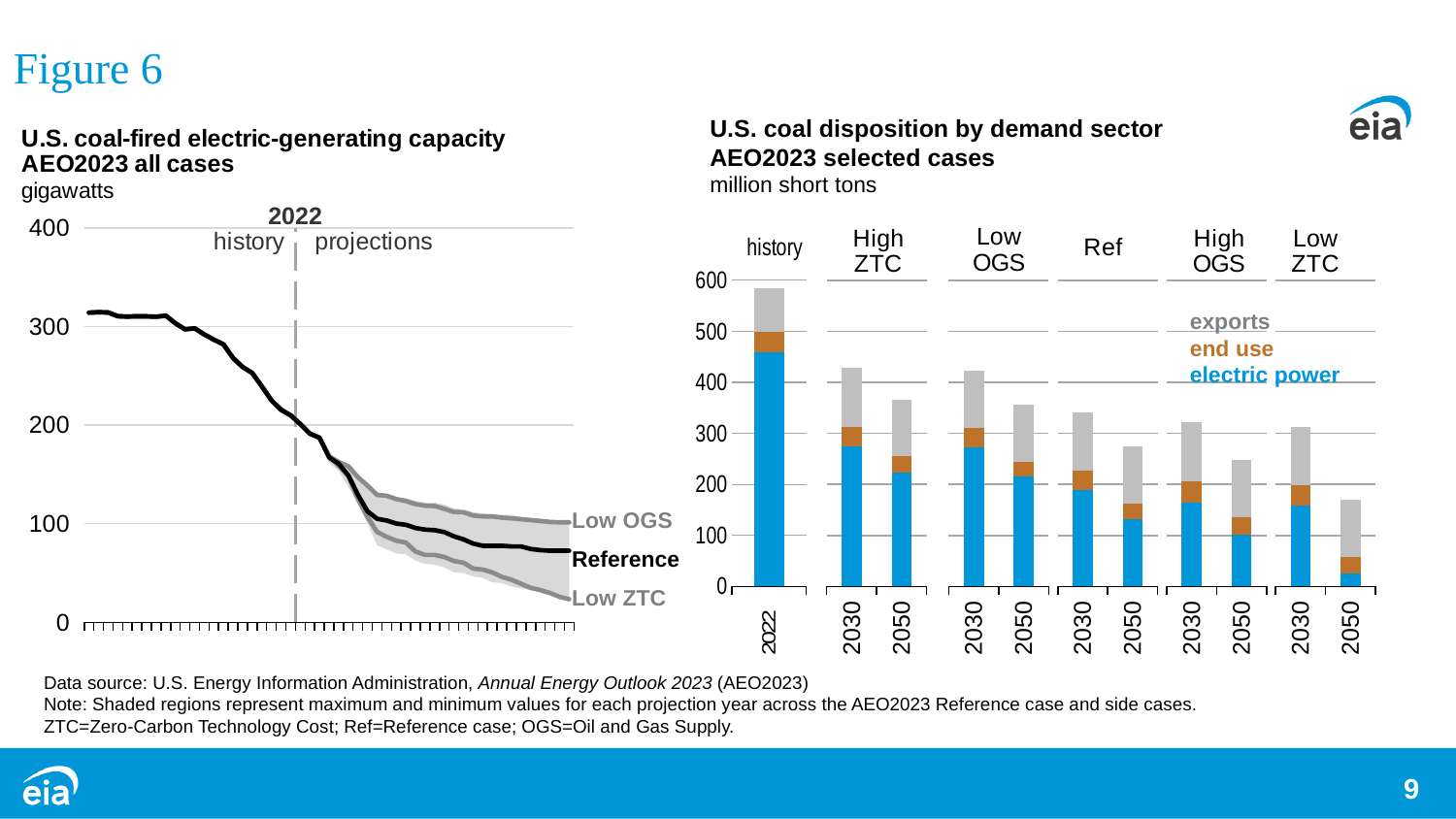
In the right chart, is the total for the Low ZTC case in 2050 greater or less than 200 million short tons? less In the right chart, which case has the lowest total coal disposition in 2050? Low ZTC In the left chart, is the Reference case value at the end of the projection period greater or less than 100 gigawatts? less In the left chart, does U.S. coal-fired electric-generating capacity rise or fall over time? fall How many series does the legend of the right chart list? 3 In the right chart, is the total coal disposition in 2022 greater or less than 500 million short tons? greater What kind of chart is the right chart, 'U.S. coal disposition by demand sector'? bar chart How many bars are plotted in the right chart? 11 In the left chart, which year separates history from projections? 2022 What kind of chart is the left chart, 'U.S. coal-fired electric-generating capacity'? line chart